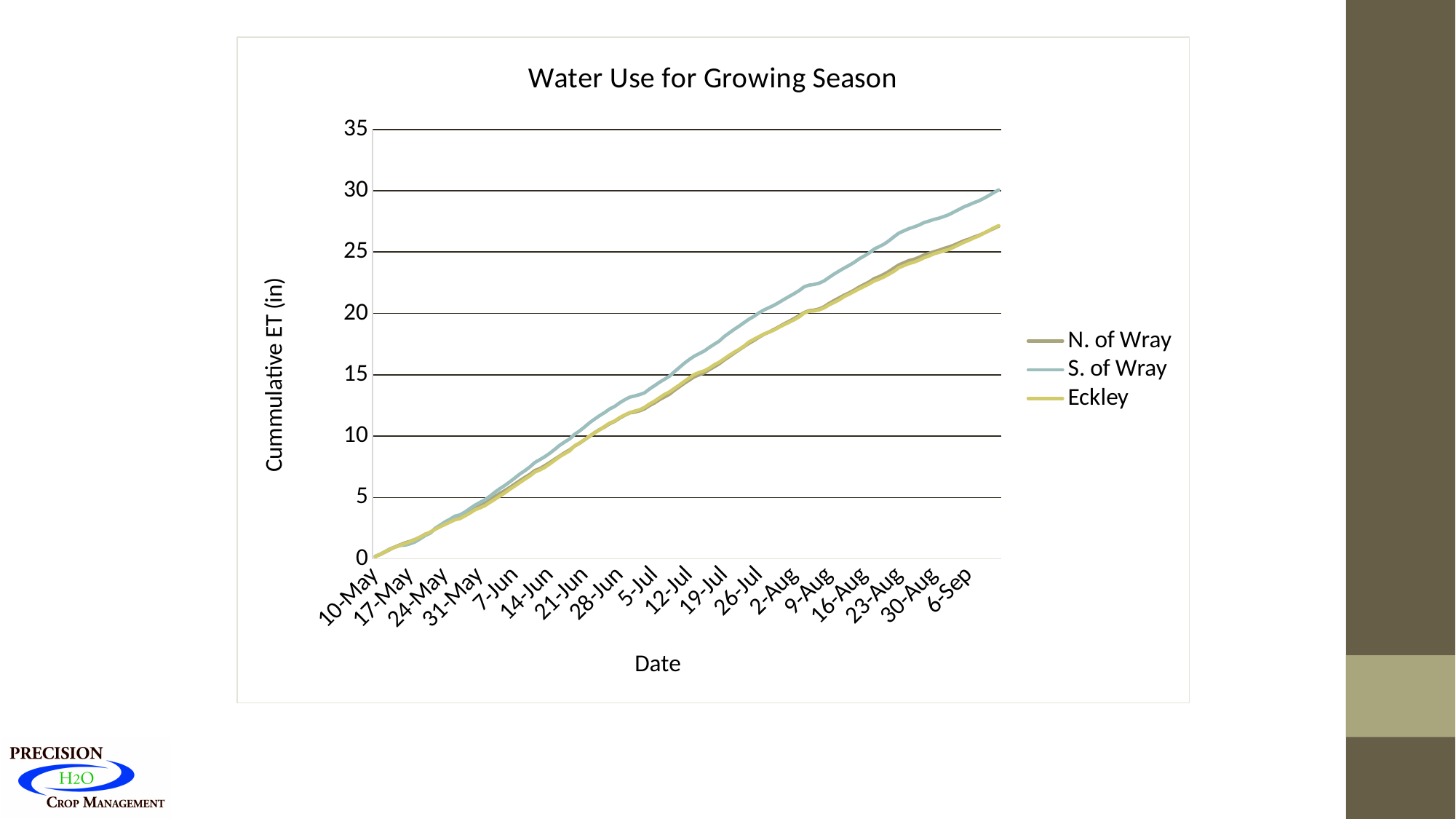
Which series has the highest value at 6-Sep? S. of Wray Is the value for N. of Wray at 6-Sep greater or less than 30? less What kind of chart is shown on the slide? line chart Is the value for S. of Wray at 9-Aug greater or less than 20? greater Is the value for S. of Wray at 6-Sep greater or less than 25? greater What is the label of the vertical axis? Cummulative ET (in) What is the title of the chart? Water Use for Growing Season How many date labels are shown on the x axis? 18 How many series does the legend list? 3 At 6-Sep, which is larger: the value for S. of Wray or the value for Eckley? S. of Wray Do the values for S. of Wray rise or fall along the x axis? rise